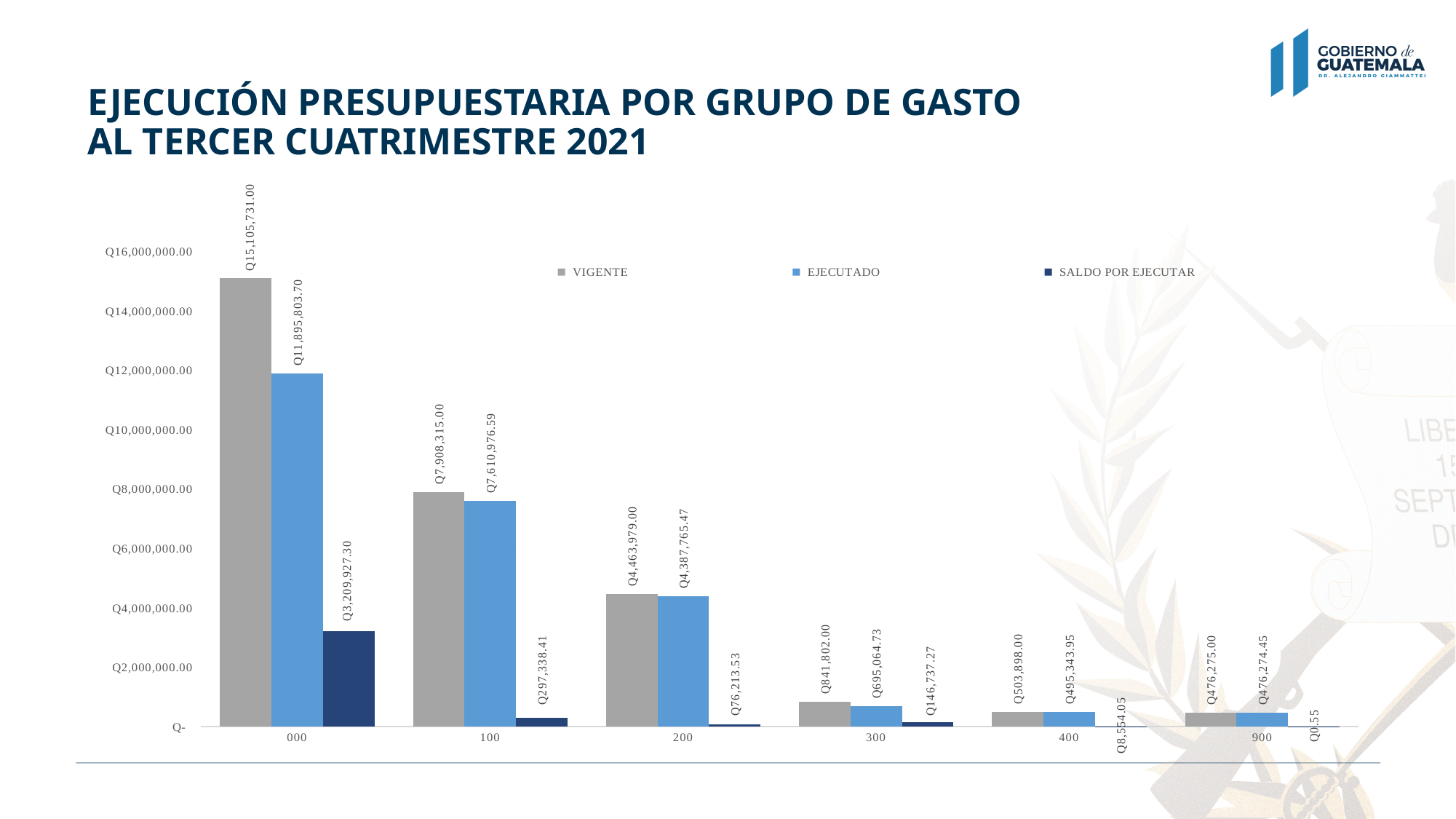
What is the SALDO POR EJECUTAR value for group 900? Q0.55 Which group has the lowest SALDO POR EJECUTAR value? 900 How many expense group categories are shown on the x axis? 6 How many series does the legend list? 3 What type of chart is shown on the slide? Bar chart What is the EJECUTADO value for group 100? Q7,610,976.59 What is the SALDO POR EJECUTAR value for group 300? Q146,737.27 What is the VIGENTE value for group 000? Q15,105,731.00 Which is larger, the EJECUTADO value for group 200 or the EJECUTADO value for group 300? Group 200 Which group has the highest VIGENTE value? 000 What is the difference between the VIGENTE and EJECUTADO values for group 000? Q3,209,927.30 Do the VIGENTE values rise or fall from group 000 to group 400 along the x axis? Fall